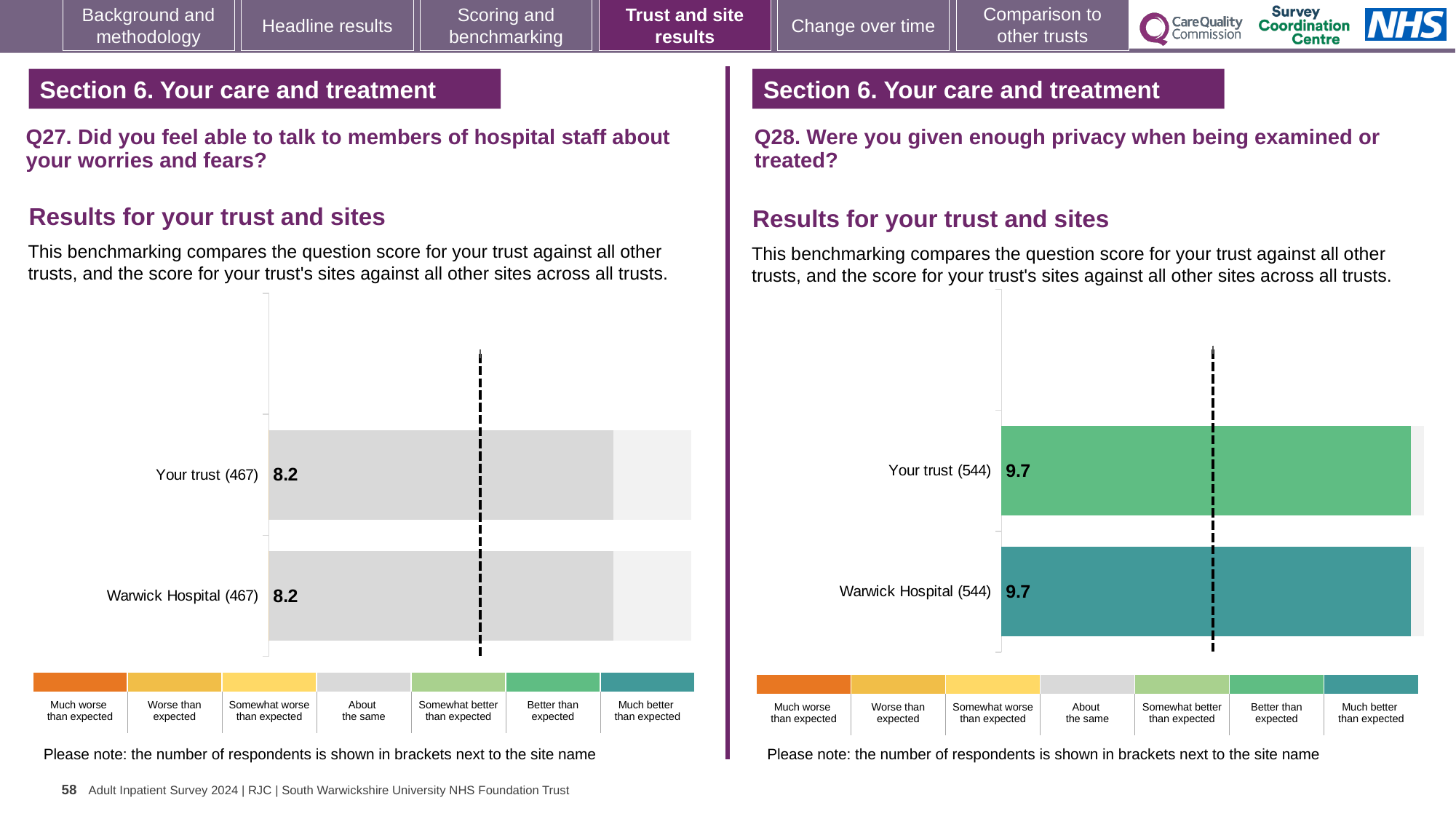
In the Q28 chart on the right, which benchmark category does the colour of the Warwick Hospital bar correspond to in the legend? Much better than expected In the Q27 chart on the left, what is the score for Your trust? 8.2 In the Q28 chart on the right, what is the score for Your trust? 9.7 How many bars are plotted in the Q28 chart on the right? 2 In the Q27 chart on the left, how many respondents are shown in brackets next to Your trust? 467 In the Q27 chart on the left, what is the score for Warwick Hospital? 8.2 In the Q28 chart on the right, what is the score for Warwick Hospital? 9.7 In the Q28 chart on the right, what is the difference between the Your trust score and the Warwick Hospital score? 0 In the Q28 chart on the right, how many respondents are shown in brackets next to Warwick Hospital? 544 What kind of chart is used for the Q27 results on the left? Bar chart How many bars are plotted in the Q27 chart on the left? 2 In the Q27 chart on the left, what is the difference between the Your trust score and the Warwick Hospital score? 0